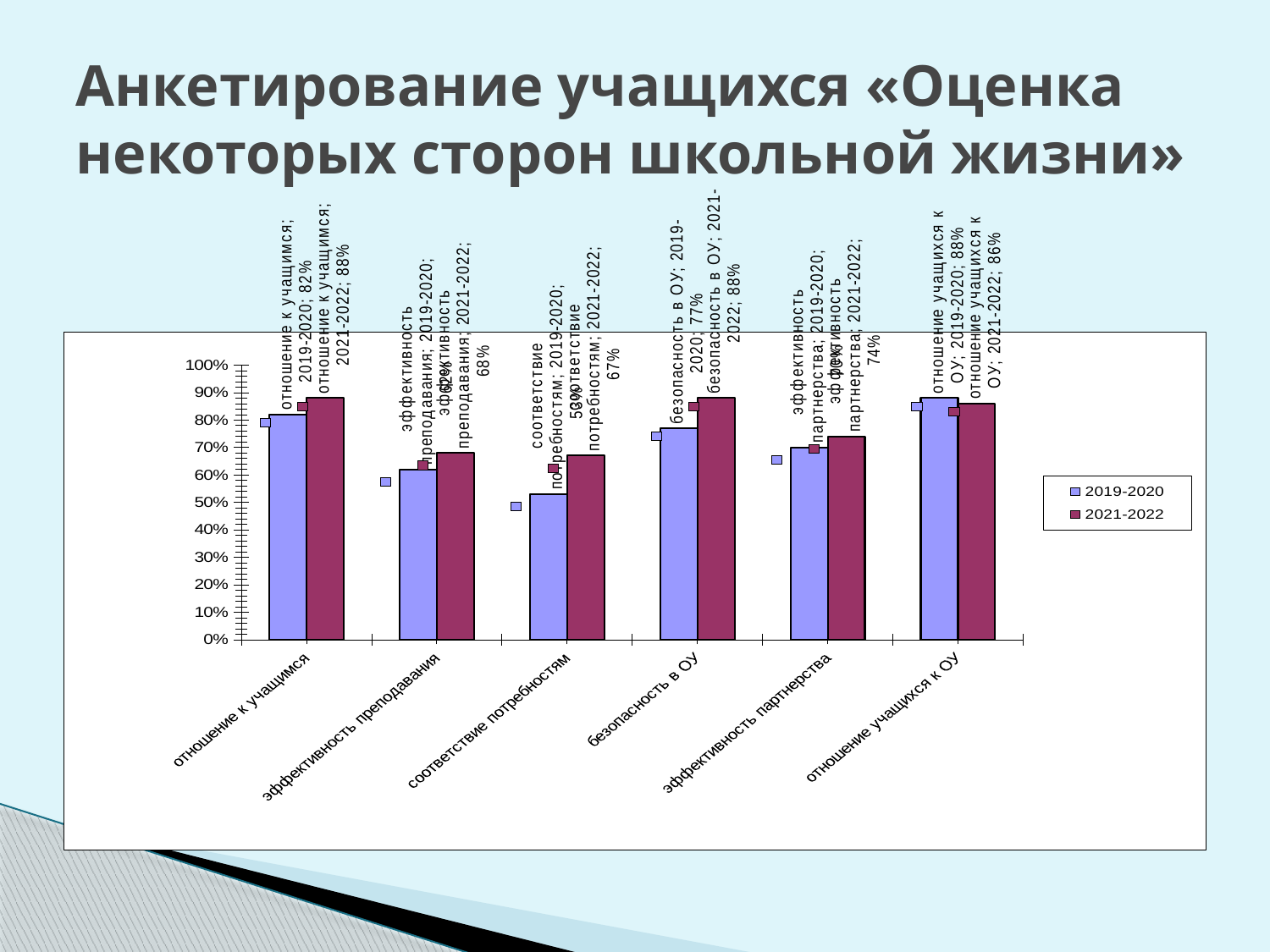
How many categories are shown on the x axis of the chart? 6 What is the value for «безопасность в ОУ» in the 2019-2020 series? 77% Is the 2019-2020 value for «соответствие потребностям» greater or less than 60%? less By how many percentage points did «отношение к учащимся» change from 2019-2020 (82%) to 2021-2022 (88%)? 6 percentage points What is the value for «эффективность преподавания» in the 2021-2022 series? 68% What kind of chart is shown on the slide? bar chart For «отношение учащихся к ОУ», which series has the larger value, 2019-2020 or 2021-2022? 2019-2020 Which category has the lowest value in the 2019-2020 series? соответствие потребностям How many series does the legend list? 2 What is the value for «соответствие потребностям» in the 2021-2022 series? 67% What is the value for «отношение к учащимся» in the 2021-2022 series? 88% What is the value for «отношение учащихся к ОУ» in the 2019-2020 series? 88%